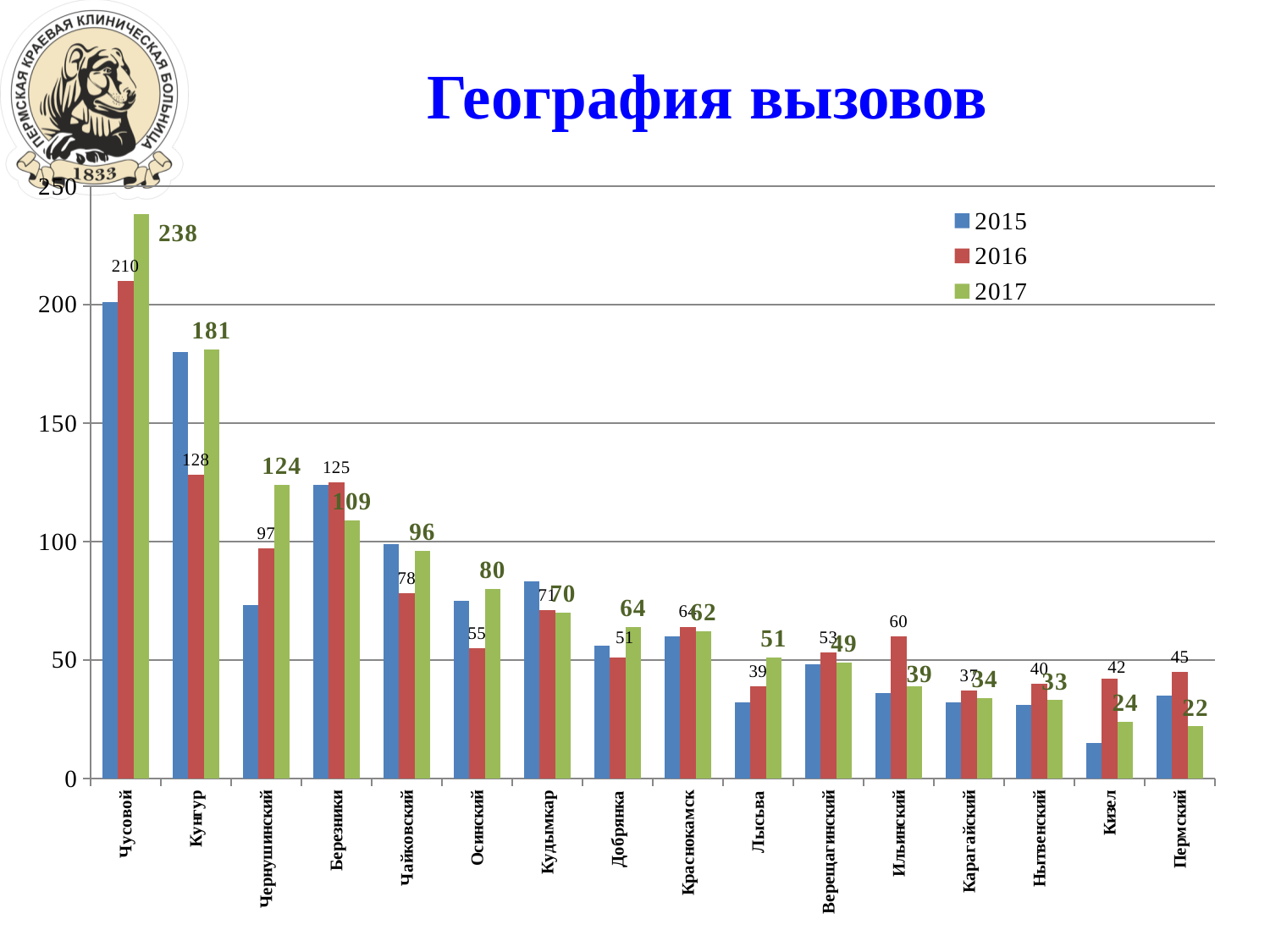
What is the value for Кунгур in the 2016 series? 128 Which category has the lowest value in the 2017 series? Пермский What is the value for Ильинский in the 2016 series? 60 What kind of chart is shown on the slide? bar chart How many series does the legend list? 3 What is the difference between the 2017 and 2016 values for Чусовой? 28 Is the 2015 value for Кунгур greater or less than 150? greater Which category has the highest value in the 2017 series? Чусовой For Кизел, which is larger: the 2016 value or the 2017 value? 2016 How many categories are shown on the x axis? 16 What is the value for Чусовой in the 2017 series? 238 Do the 2017 values rise or fall from left to right along the x axis? fall